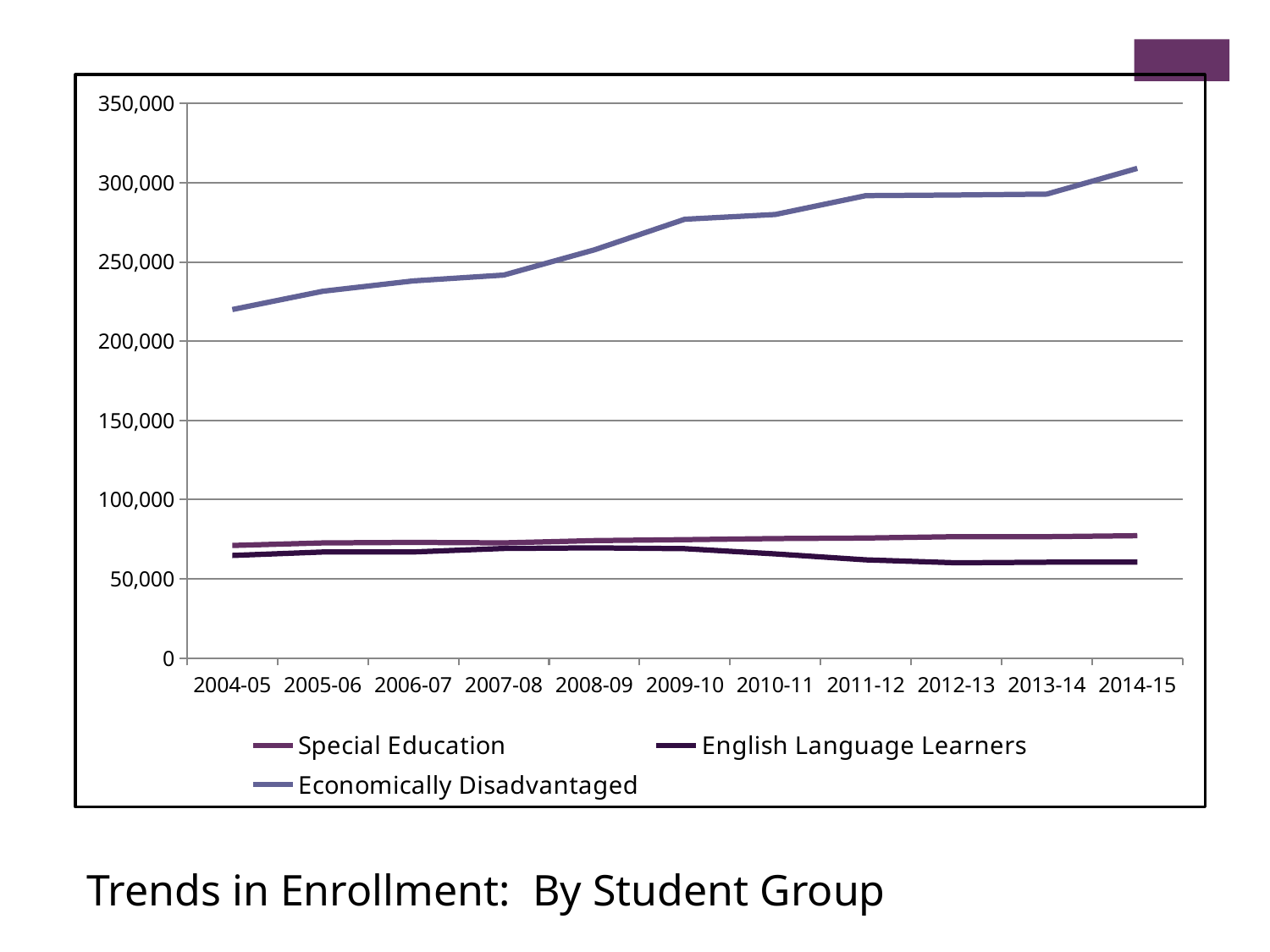
Is the Special Education value for 2014-15 greater or less than 100,000? less In which school year is the Economically Disadvantaged value highest? 2014-15 Is the Economically Disadvantaged value for 2004-05 greater or less than 250,000? less How many series does the legend list? 3 In which school year is the Economically Disadvantaged value lowest? 2004-05 Does the Economically Disadvantaged line rise or fall from 2004-05 to 2014-15? rise What kind of chart is shown on the slide? line chart What is the title shown below the chart? Trends in Enrollment: By Student Group Does the English Language Learners line rise or fall from 2009-10 to 2012-13? fall In 2014-15, which is larger: Special Education or English Language Learners? Special Education Is the Economically Disadvantaged value for 2014-15 greater or less than 300,000? greater How many school years are shown along the x axis? 11